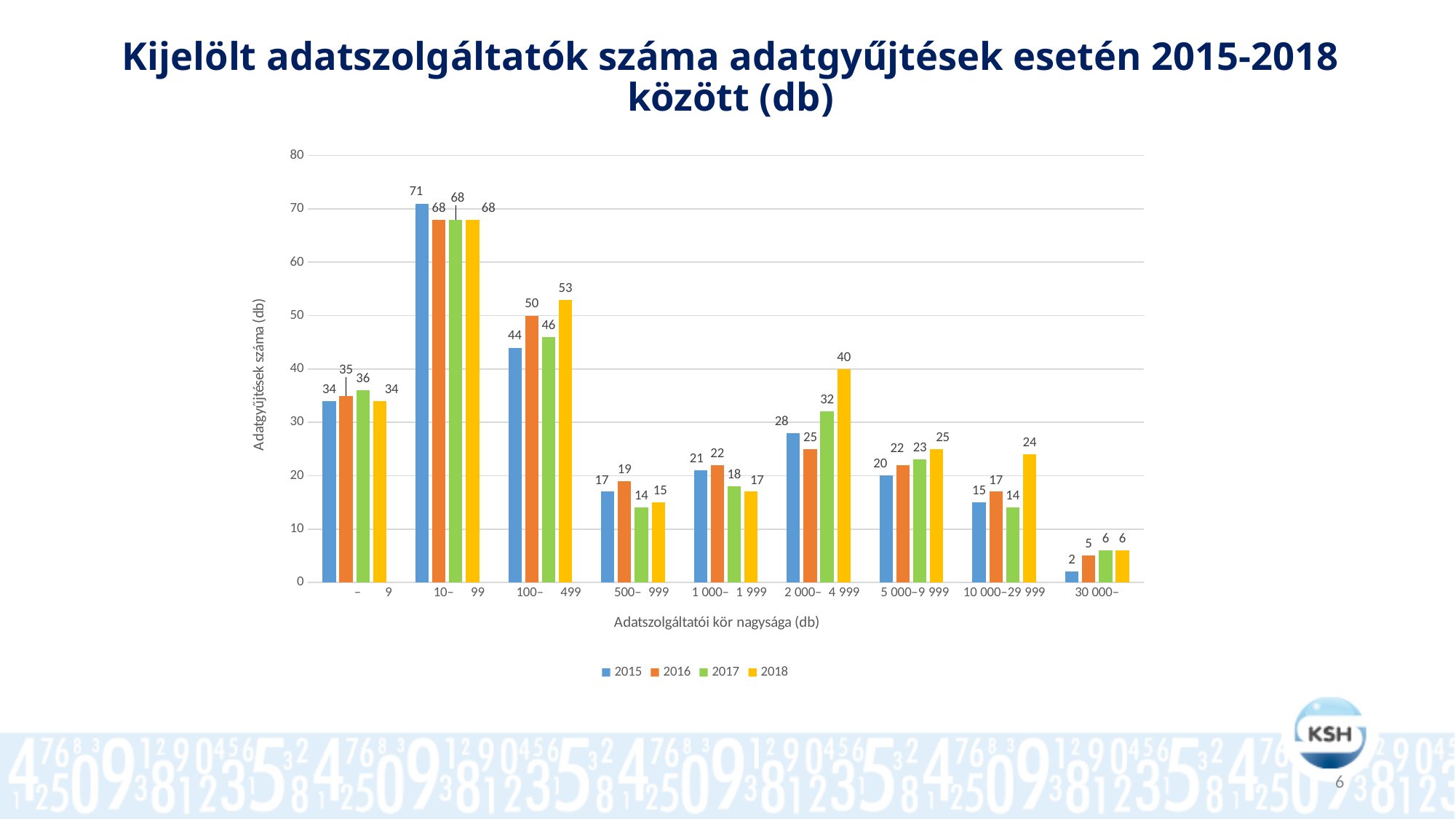
How many series does the legend list? 4 Which category has the highest value for 2016? 10–99 What is the label of the y axis? Adatgyűjtések száma (db) What is the value for 2017 in the 2 000–4 999 category? 32 What kind of chart is shown on the slide? bar chart What is the difference between the 2018 and 2015 values in the 2 000–4 999 category? 12 Which category has the lowest value for 2015? 30 000– How many categories are shown on the x axis? 9 What is the value for 2018 in the 100–499 category? 53 What is the value for 2015 in the 10–99 category? 71 Which is larger in the 10 000–29 999 category: the 2016 value or the 2018 value? 2018 What is the value for 2016 in the 30 000– category? 5